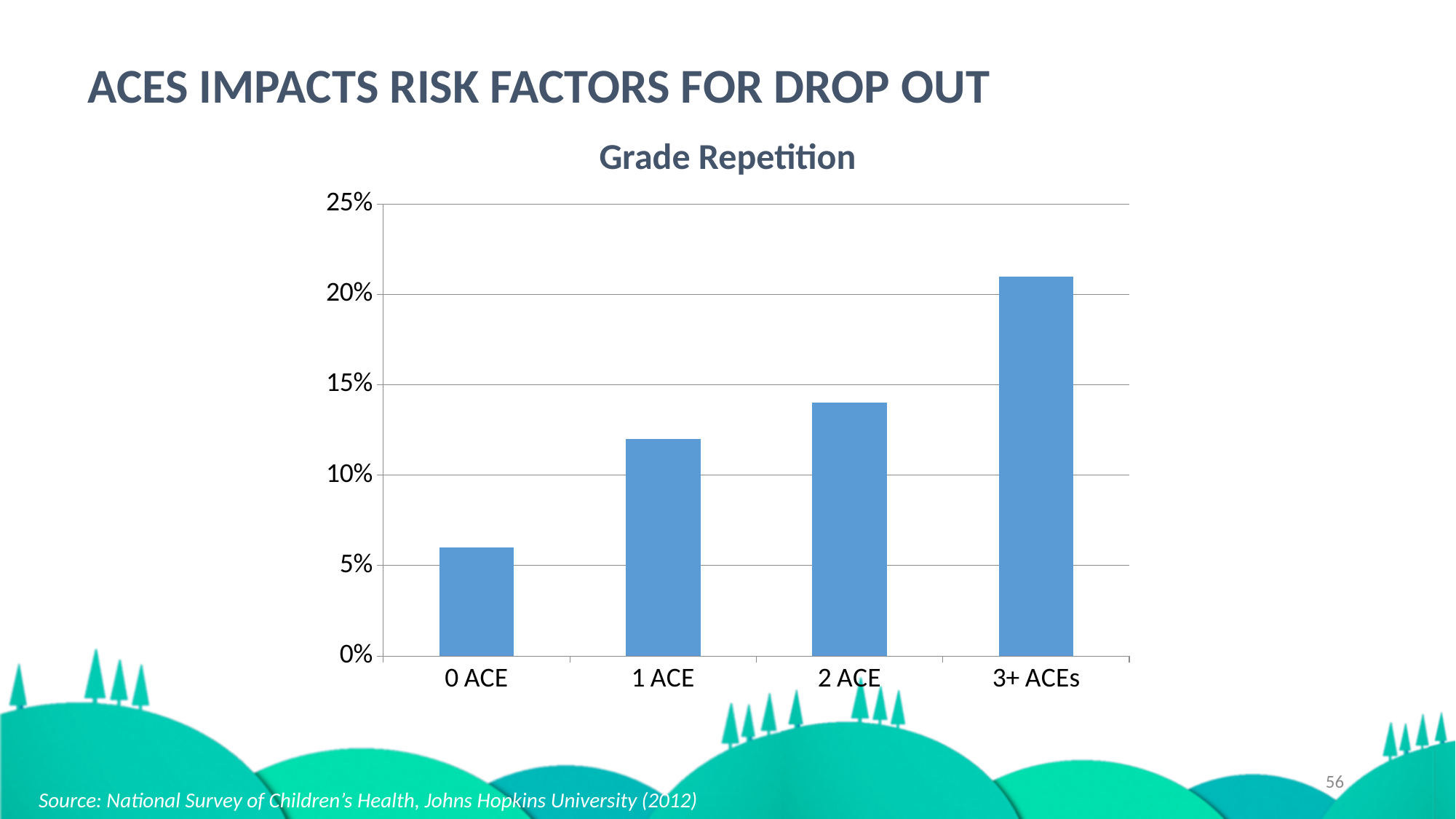
How many categories are shown on the x axis of the chart? 4 What kind of chart is shown on the slide? bar chart Is the value for 3+ ACEs greater or less than 20%? greater Do the values rise or fall as you move from 0 ACE to 3+ ACEs along the x axis? rise Is the value for 2 ACE greater or less than 15%? less What is the highest value shown on the y axis of the chart? 25% Is the value for 0 ACE greater or less than 10%? less Which is larger, the value for 1 ACE or the value for 3+ ACEs? 3+ ACEs Which category has the lowest grade repetition rate? 0 ACE Which category has the highest grade repetition rate? 3+ ACEs What is the title of the chart? Grade Repetition